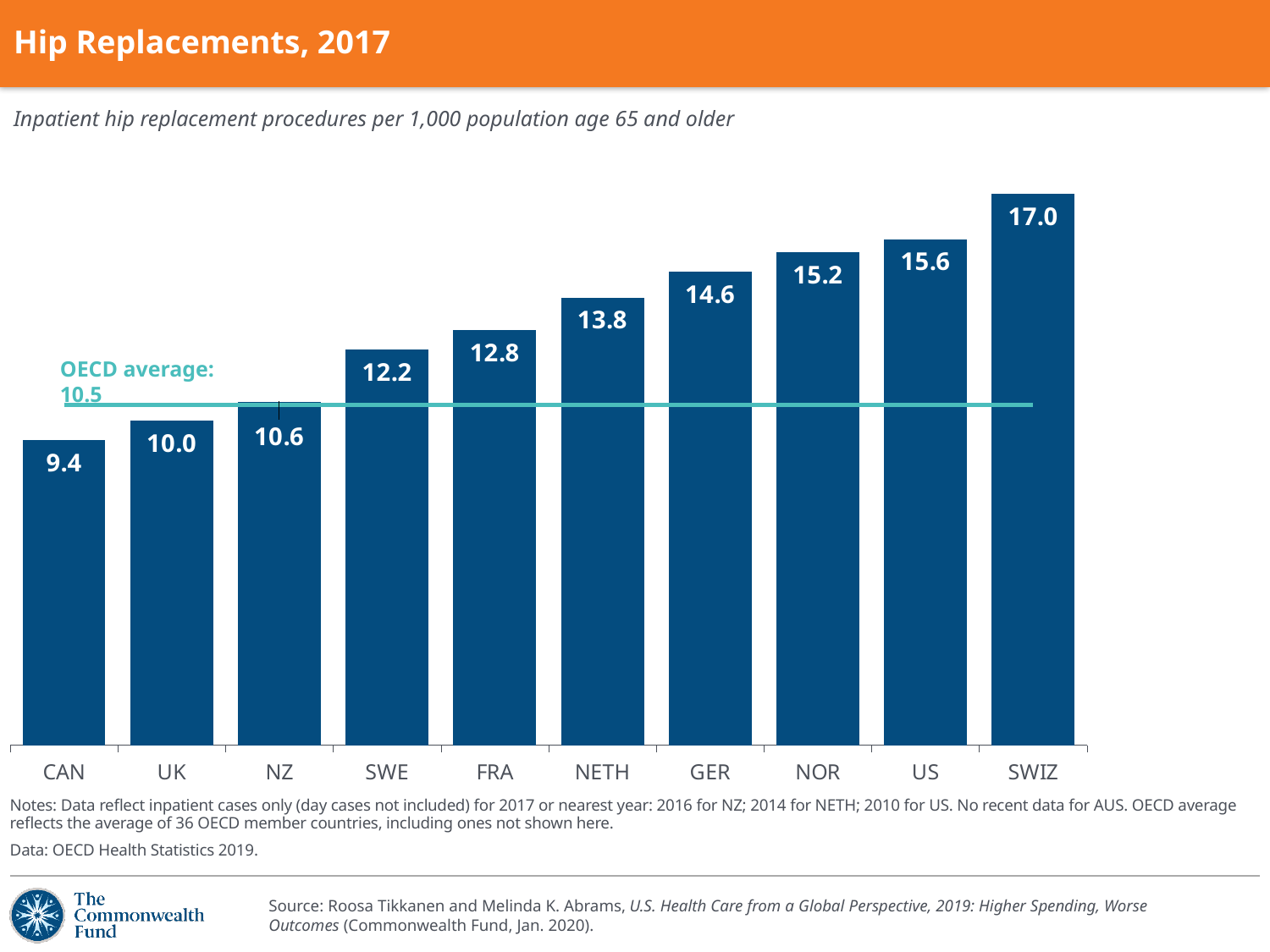
What kind of chart is this? Bar chart What is the value for NETH? 13.8 What is the difference between the values for SWIZ and CAN? 7.6 How many countries are shown in the chart? 10 Which has a higher value, FRA or SWE? FRA What is the value for CAN? 9.4 Do the values rise or fall from left to right along the x axis? Rise Which country has the highest value? SWIZ Which country has the lowest value? CAN What is the difference between the values for US and GER? 1.0 What OECD average value is marked by the horizontal line? 10.5 What is the value for the US? 15.6